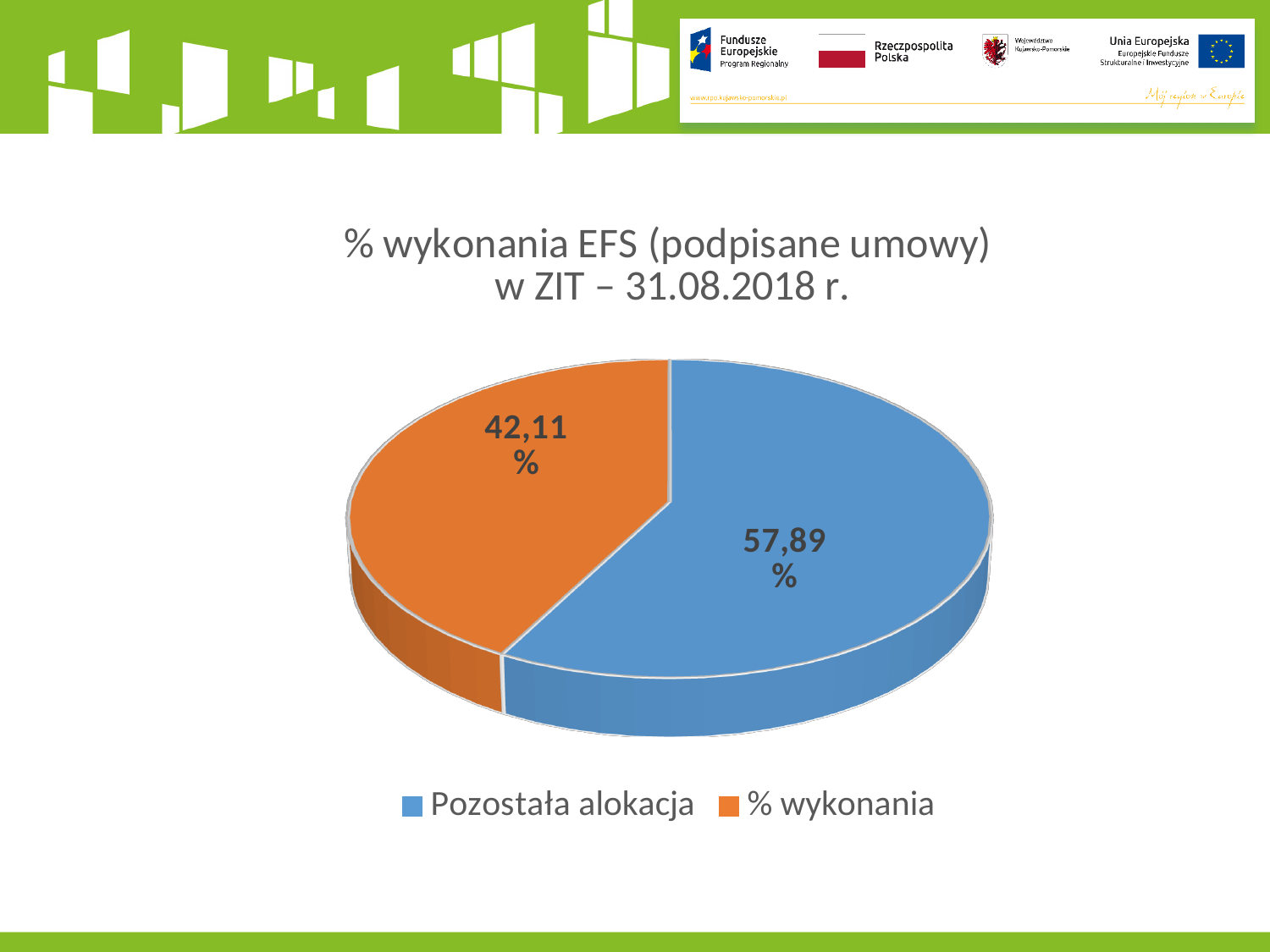
What is the value for % wykonania? 42,11% What is the difference between Pozostała alokacja and % wykonania? 15,78% What type of chart is shown on the slide? pie chart How many slices does the pie chart have? 2 What colour is the slice for % wykonania? orange Which is larger, Pozostała alokacja or % wykonania? Pozostała alokacja What share of the pie does Pozostała alokacja take? 57,89% Which slice is the largest? Pozostała alokacja Which slice is the smallest? % wykonania What is the title of the chart? % wykonania EFS (podpisane umowy) w ZIT – 31.08.2018 r. How many entries does the legend list? 2 What is the value for Pozostała alokacja? 57,89%